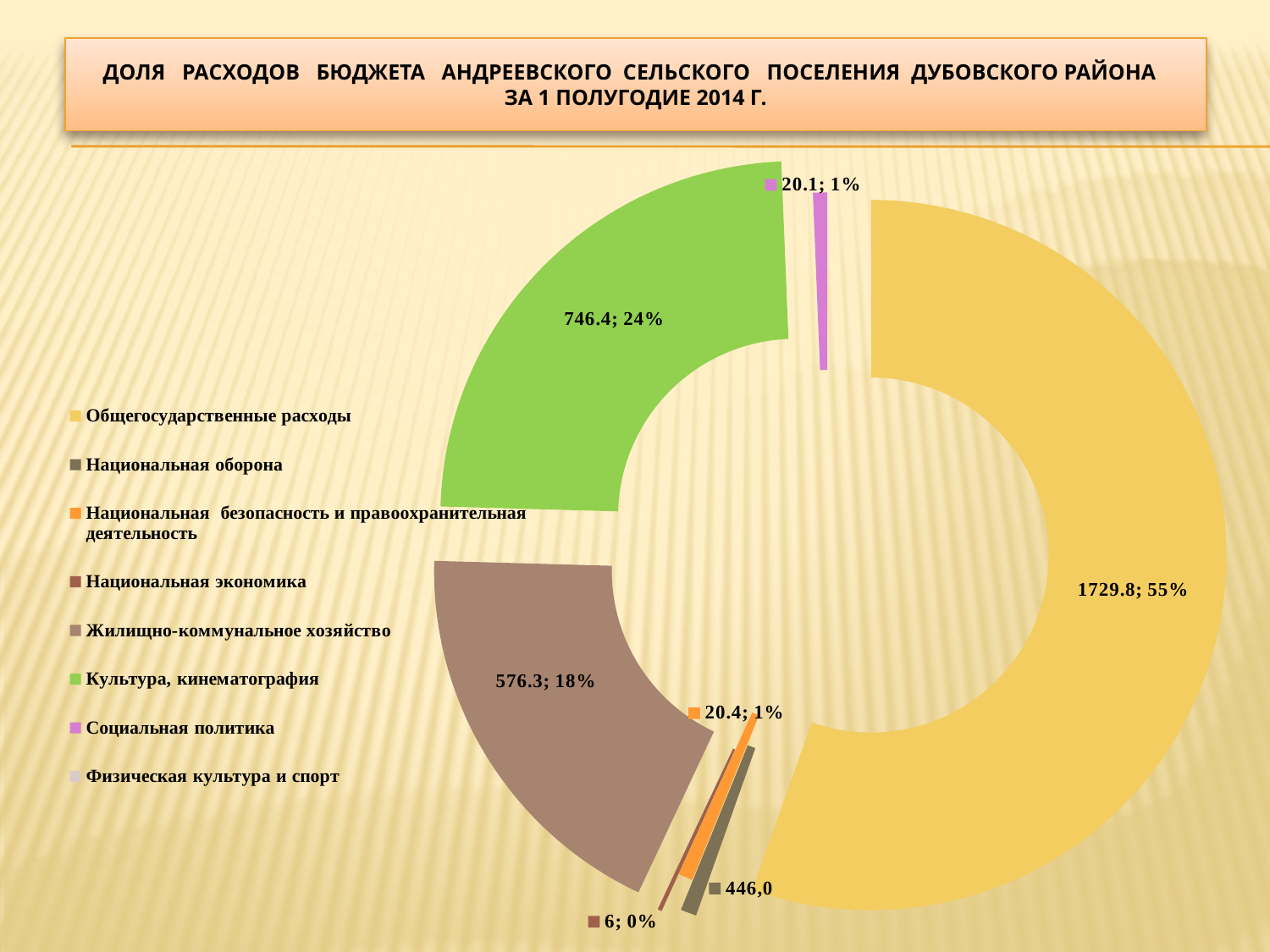
What share of the chart does Культура, кинематография represent? 24% What is the difference between the values for Общегосударственные расходы and Культура, кинематография? 983.4 What value and share are shown for Общегосударственные расходы? 1729.8; 55% What value is shown for Жилищно-коммунальное хозяйство? 576.3 What value is shown for Национальная безопасность и правоохранительная деятельность? 20.4 What value is shown for Культура, кинематография? 746.4 Which category has the largest share of the budget expenditures? Общегосударственные расходы Which is larger, the value for Культура, кинематография or for Жилищно-коммунальное хозяйство? Культура, кинематография How many categories does the legend list? 8 What kind of chart is shown on the slide? Doughnut (pie) chart What share of the chart does Жилищно-коммунальное хозяйство represent? 18% What value is shown for Социальная политика? 20.1